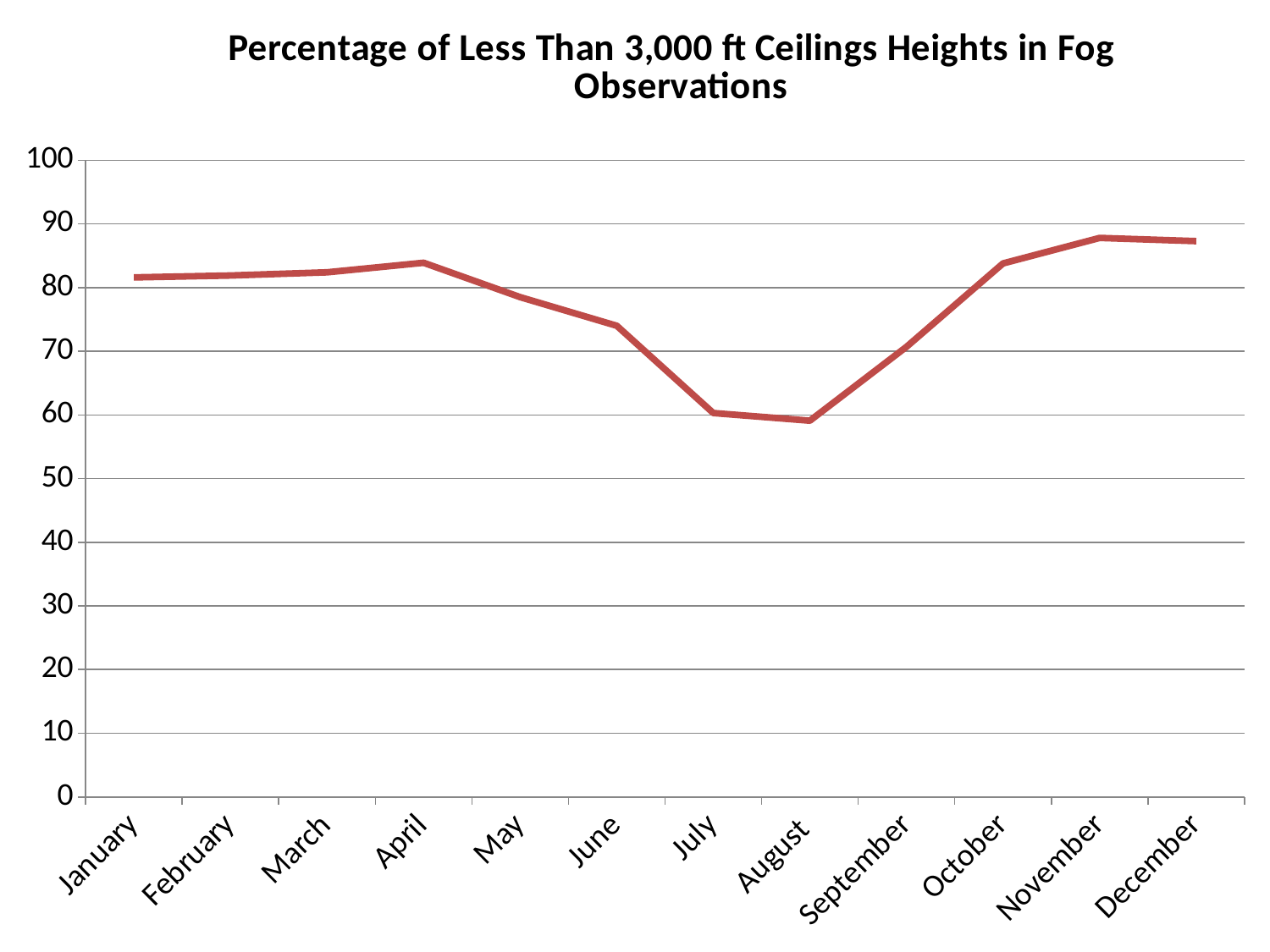
Which is larger, the value for April or the value for July? April Which is larger, the value for September or the value for October? October How many months are plotted along the x axis? 12 Do the values rise or fall from April to August? fall What is the title of the chart? Percentage of Less Than 3,000 ft Ceilings Heights in Fog Observations What kind of chart is shown on the slide? line chart Is the value for June greater or less than 70? greater Is the value for January greater or less than 80? greater Is the value for September greater or less than 80? less Which month has the lowest percentage? August Which month has the highest percentage? November